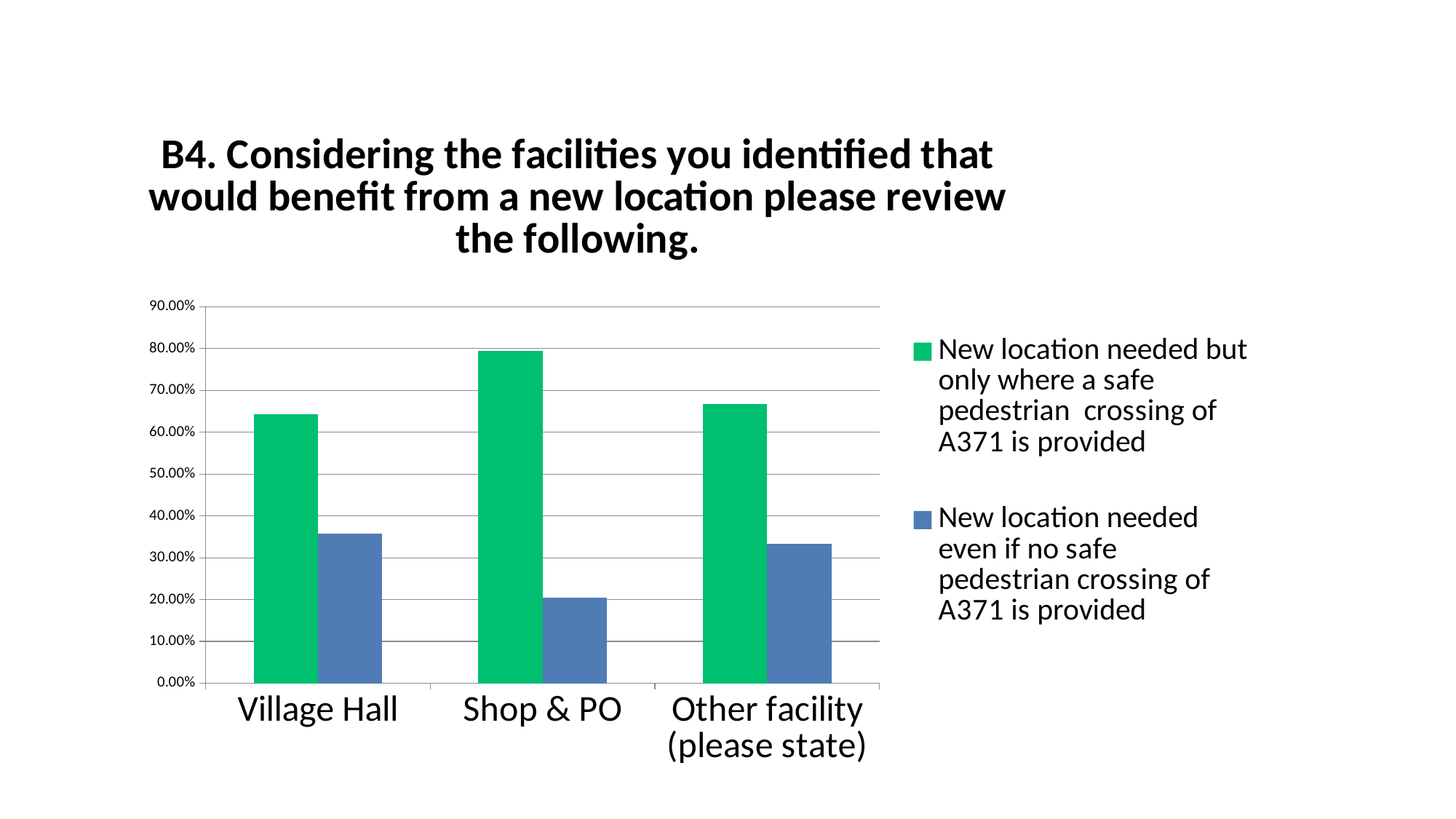
Is the value for Other facility (please state) in the 'New location needed even if no safe pedestrian crossing of A371 is provided' series greater or less than 40.00%? less Which category has the highest value for 'New location needed but only where a safe pedestrian crossing of A371 is provided'? Shop & PO Is the value for Shop & PO in the 'New location needed even if no safe pedestrian crossing of A371 is provided' series greater or less than 30.00%? less Which category has the highest value for 'New location needed even if no safe pedestrian crossing of A371 is provided'? Village Hall How many categories are shown on the x axis of the chart? 3 For Village Hall, which series has the larger value: 'New location needed but only where a safe pedestrian crossing of A371 is provided' or 'New location needed even if no safe pedestrian crossing of A371 is provided'? New location needed but only where a safe pedestrian crossing of A371 is provided What colour are the bars for the 'New location needed even if no safe pedestrian crossing of A371 is provided' series? Blue What type of chart is shown on the slide? Bar chart Which category has the lowest value for 'New location needed even if no safe pedestrian crossing of A371 is provided'? Shop & PO Is the value for Shop & PO in the 'New location needed but only where a safe pedestrian crossing of A371 is provided' series greater or less than 70.00%? greater How many series does the chart's legend list? 2